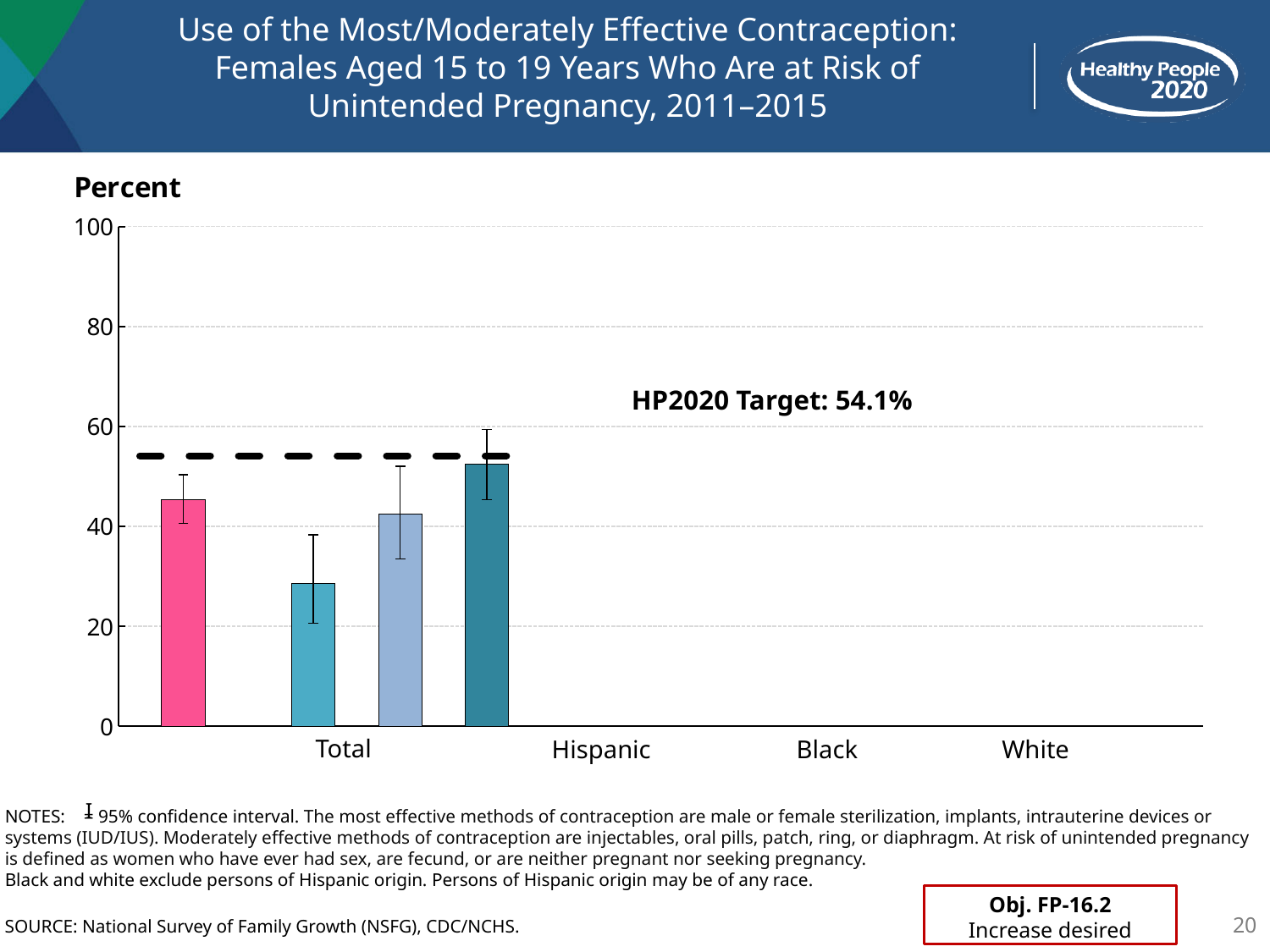
Is the value of the first (pink) bar greater or less than 40? greater Is the value of the third (light blue) bar greater or less than 60? less What kind of chart is shown on the slide? bar chart What does the dashed horizontal line on the chart represent? HP2020 Target: 54.1% Which is larger, the first (pink) bar or the second (teal) bar? the first (pink) bar Which bar is the shortest on the chart? the second (teal) bar Is the value of the second (teal) bar greater or less than 40? less What is the HP2020 Target value shown on the chart? 54.1% How many categories are labelled on the x axis of the chart? 4 Which bar is the tallest on the chart? the fourth (dark teal) bar What label is shown on the vertical axis of the chart? Percent